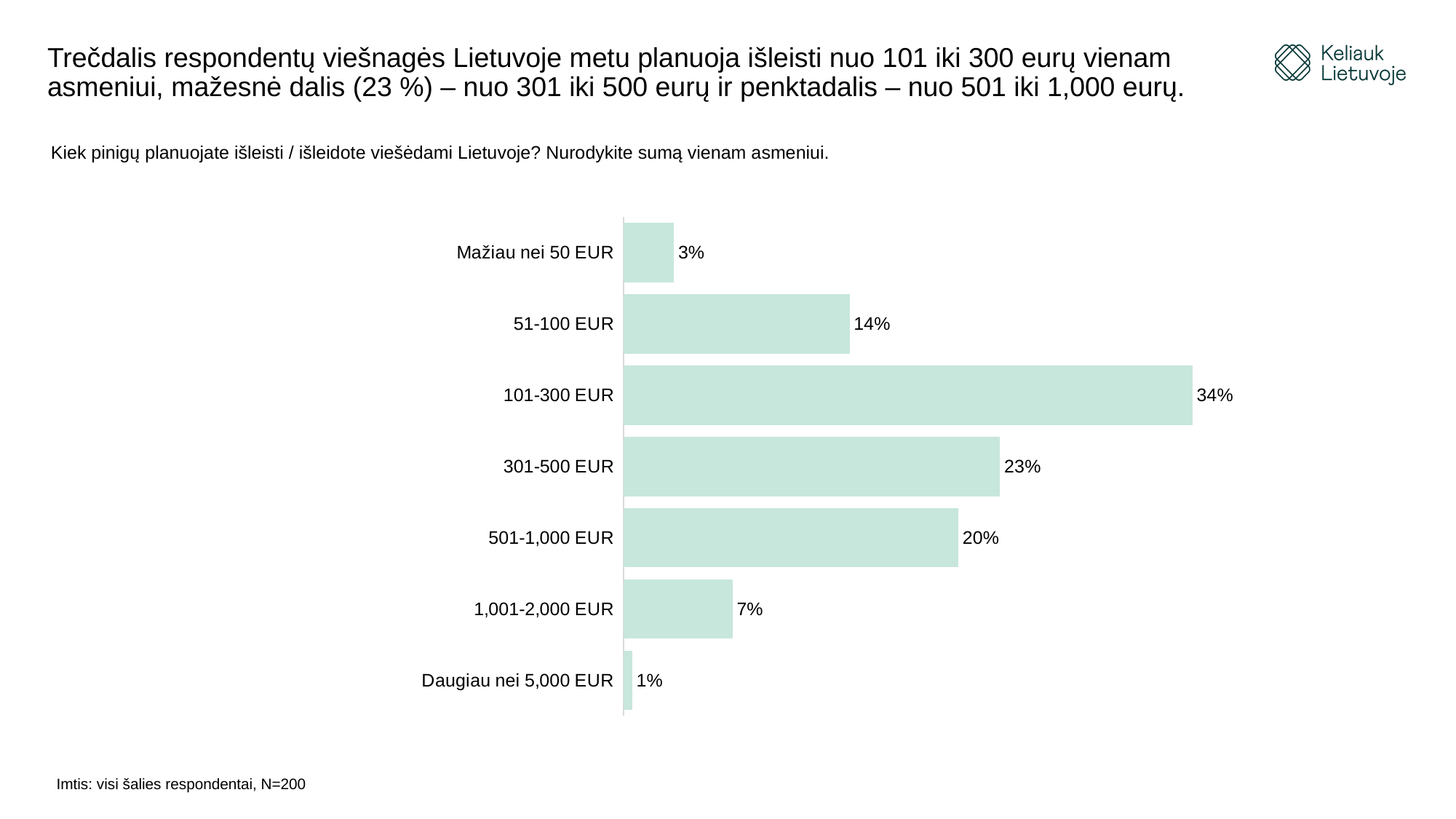
Which spending category has the highest percentage? 101-300 EUR What type of chart is shown on the slide? Bar chart What is the difference in percentage points between the 51-100 EUR and Mažiau nei 50 EUR categories? 11 Which is larger: the value for Mažiau nei 50 EUR or the value for 1,001-2,000 EUR? 1,001-2,000 EUR How many spending categories are shown in the chart? 7 What percentage is shown for 1,001-2,000 EUR? 7% What is the difference in percentage points between the 101-300 EUR and 301-500 EUR categories? 11 Which is larger: the value for 301-500 EUR or the value for 501-1,000 EUR? 301-500 EUR What is the value shown for the 51-100 EUR category? 14% Which spending category has the lowest percentage? Daugiau nei 5,000 EUR What is the sample size stated at the bottom of the slide? N=200 What percentage of respondents plan to spend 101-300 EUR per person? 34%